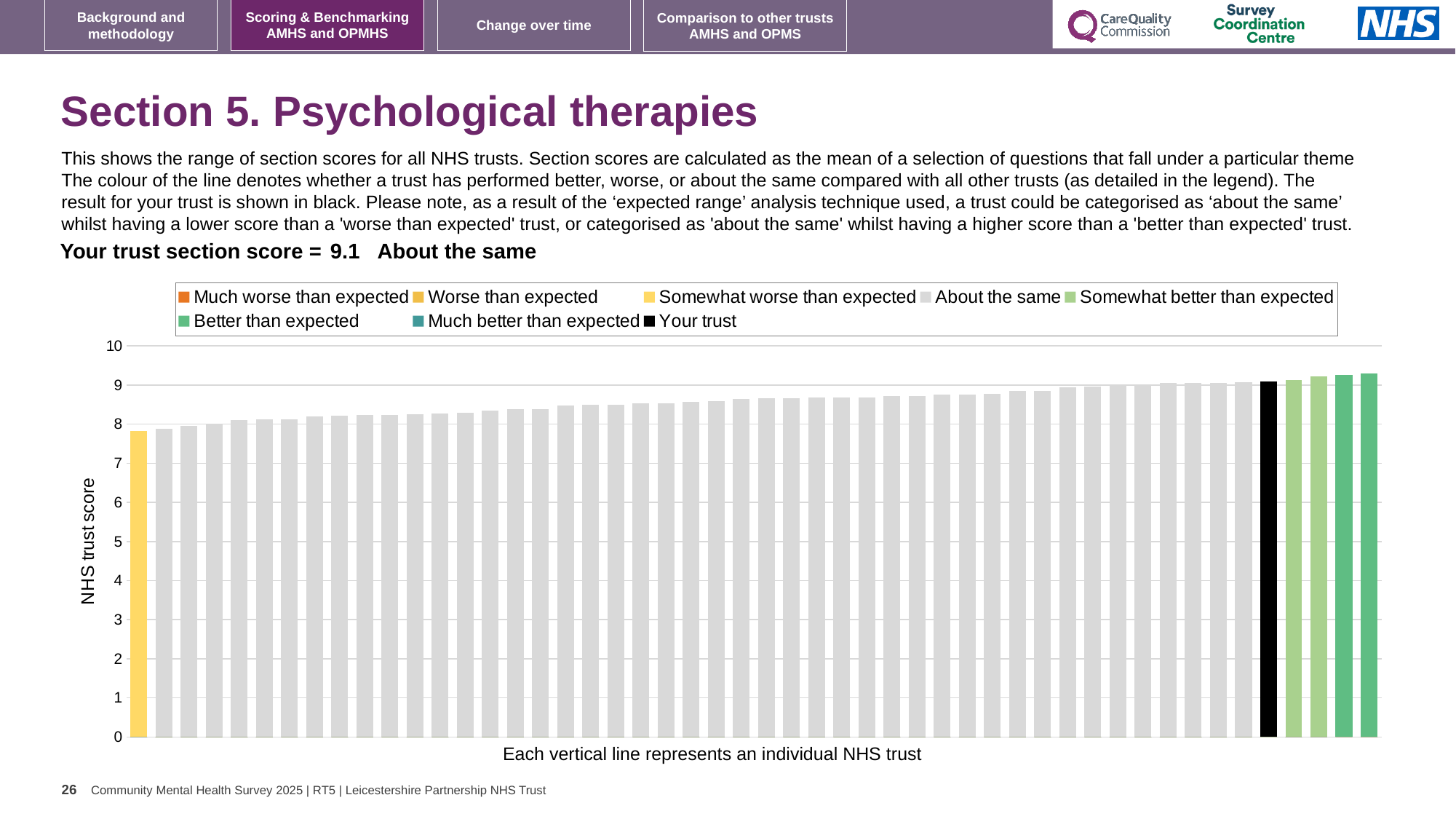
Which bar is the lowest: the leftmost bar or the black bar? the leftmost bar Is the value of the rightmost bar greater or less than 10? less Is the value of the rightmost bar greater or less than 9? greater Do the bar values rise or fall from left to right along the x axis? rise Is the value for your trust (the black bar) greater or less than 9? greater What kind of chart is shown on the slide? bar chart How many entries does the chart legend list? 8 What is the label on the vertical axis of the chart? NHS trust score How many bars in the chart are coloured yellow? 1 What colour is the bar representing your trust? black What is the section score for your trust shown on the slide? 9.1